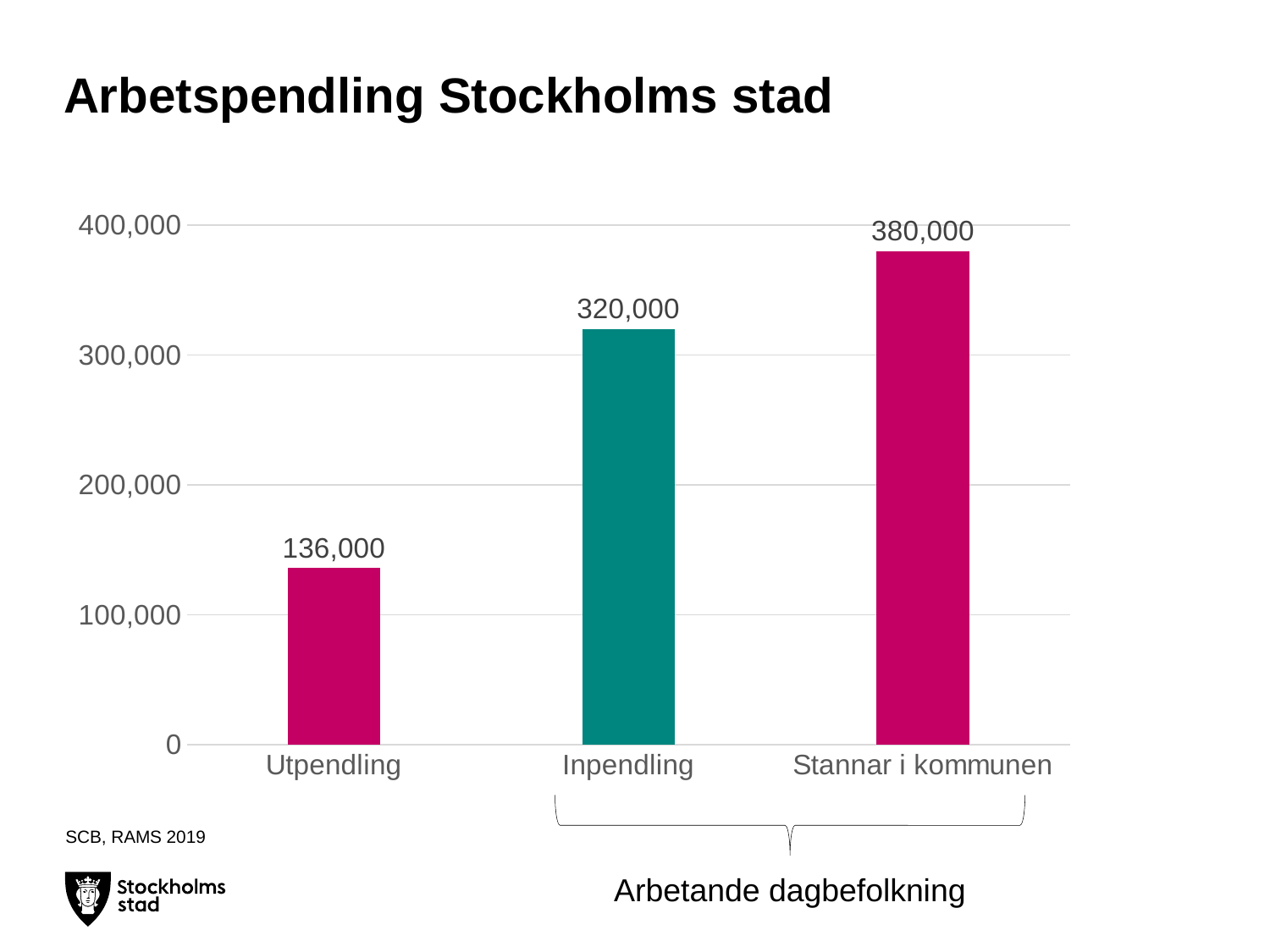
What is the value for Stannar i kommunen? 380,000 What is the difference between Stannar i kommunen and Inpendling? 60,000 What is the difference between Inpendling and Utpendling? 184,000 Is the value for Utpendling greater or less than 200,000? less Which category has the lowest value? Utpendling How many categories are shown on the x axis? 3 What is the value for Utpendling? 136,000 Which is larger, Inpendling or Utpendling? Inpendling What is the value for Inpendling? 320,000 Which category has the highest value? Stannar i kommunen What kind of chart is shown on the slide? bar chart What is the title of the chart? Arbetspendling Stockholms stad